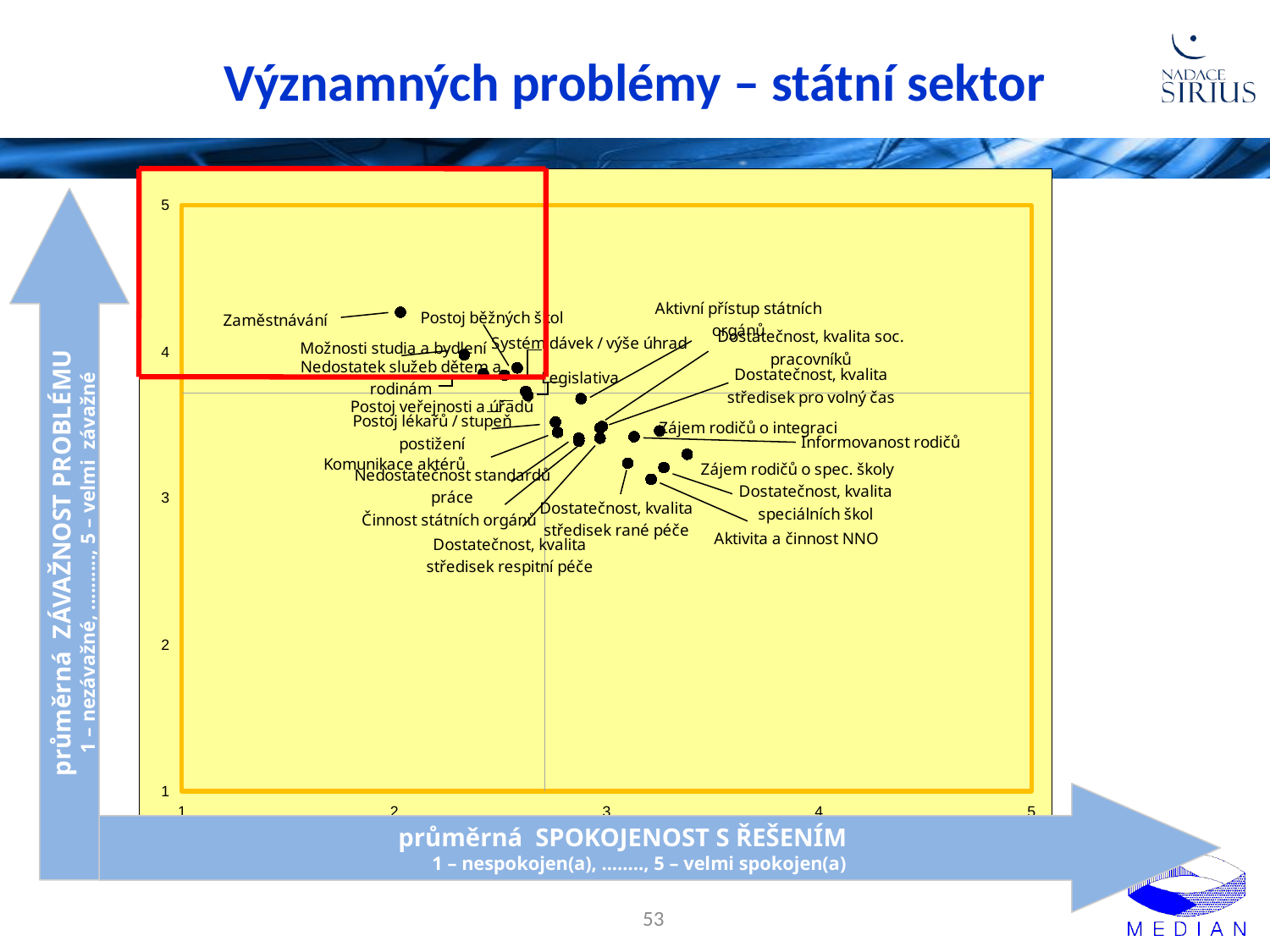
Which point is further to the right on the horizontal axis, Zaměstnávání or Aktivita a činnost NNO? Aktivita a činnost NNO What kind of chart is shown on the slide? scatter chart Is the vertical-axis value for Zaměstnávání greater or less than 4? greater Is the horizontal-axis value for Zaměstnávání greater or less than 3? less Is the vertical-axis value for Legislativa greater or less than 3? greater What is the title of the vertical axis of the chart? průměrná ZÁVAŽNOST PROBLÉMU Which point is higher on the vertical axis, Zaměstnávání or Aktivita a činnost NNO? Zaměstnávání What is the title of the horizontal axis of the chart? průměrná SPOKOJENOST S ŘEŠENÍM Which labelled point has the highest value on the vertical axis (průměrná závažnost problému)? Zaměstnávání